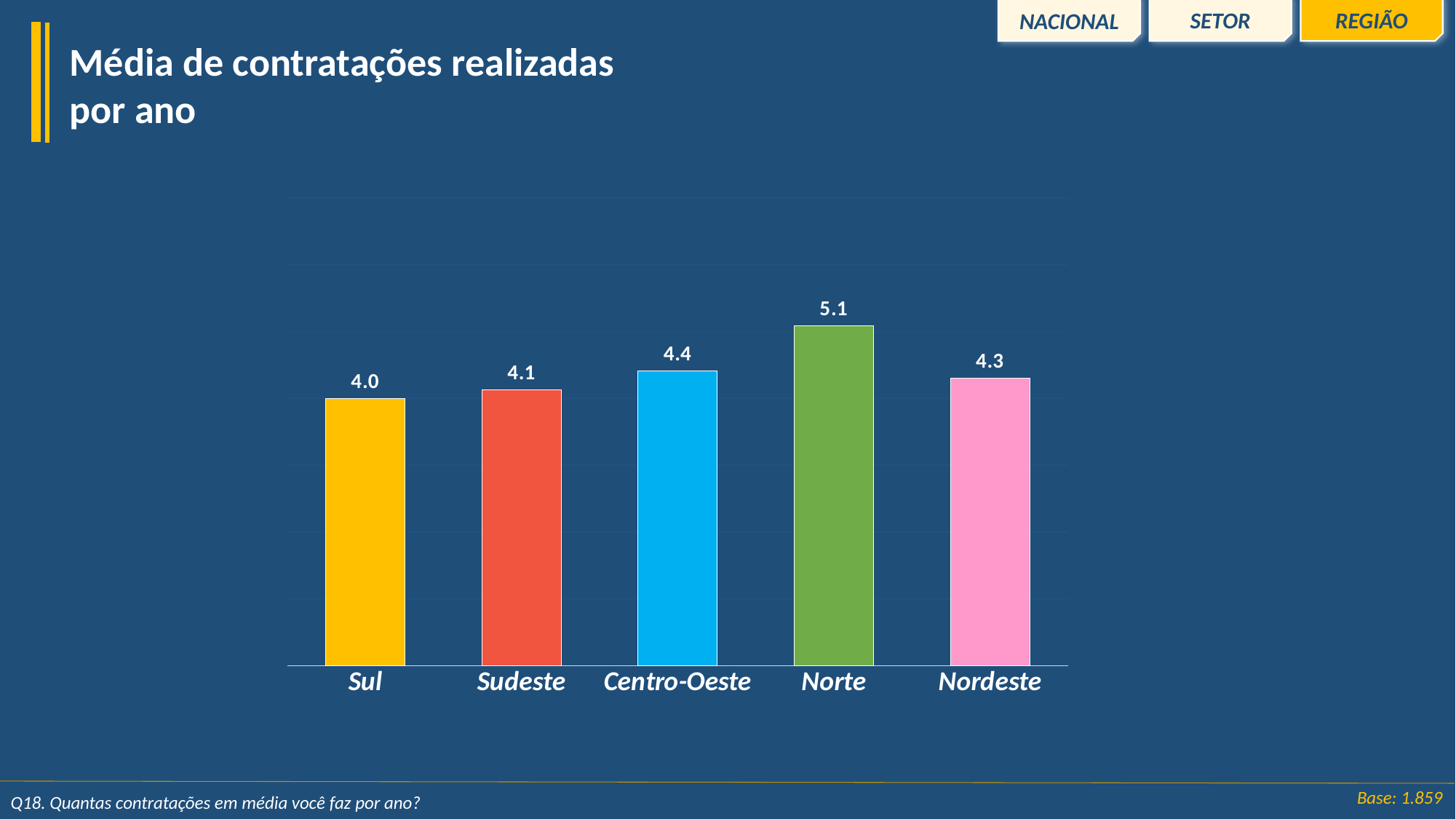
What is the value shown for Nordeste? 4.3 What is the value shown for Centro-Oeste? 4.4 Which region has the highest average number of hires per year? Norte What kind of chart is shown on the slide? Bar chart What colour is the bar for Norte? Green What is the difference between the values for Centro-Oeste and Sudeste? 0.3 Which has a higher value, Nordeste or Sudeste? Nordeste What is the value shown for Sul? 4.0 Which region has the lowest average number of hires per year? Sul What is the difference between the values for Norte and Sul? 1.1 How many regions are shown in the chart? 5 What is the average number of hires per year for Norte? 5.1